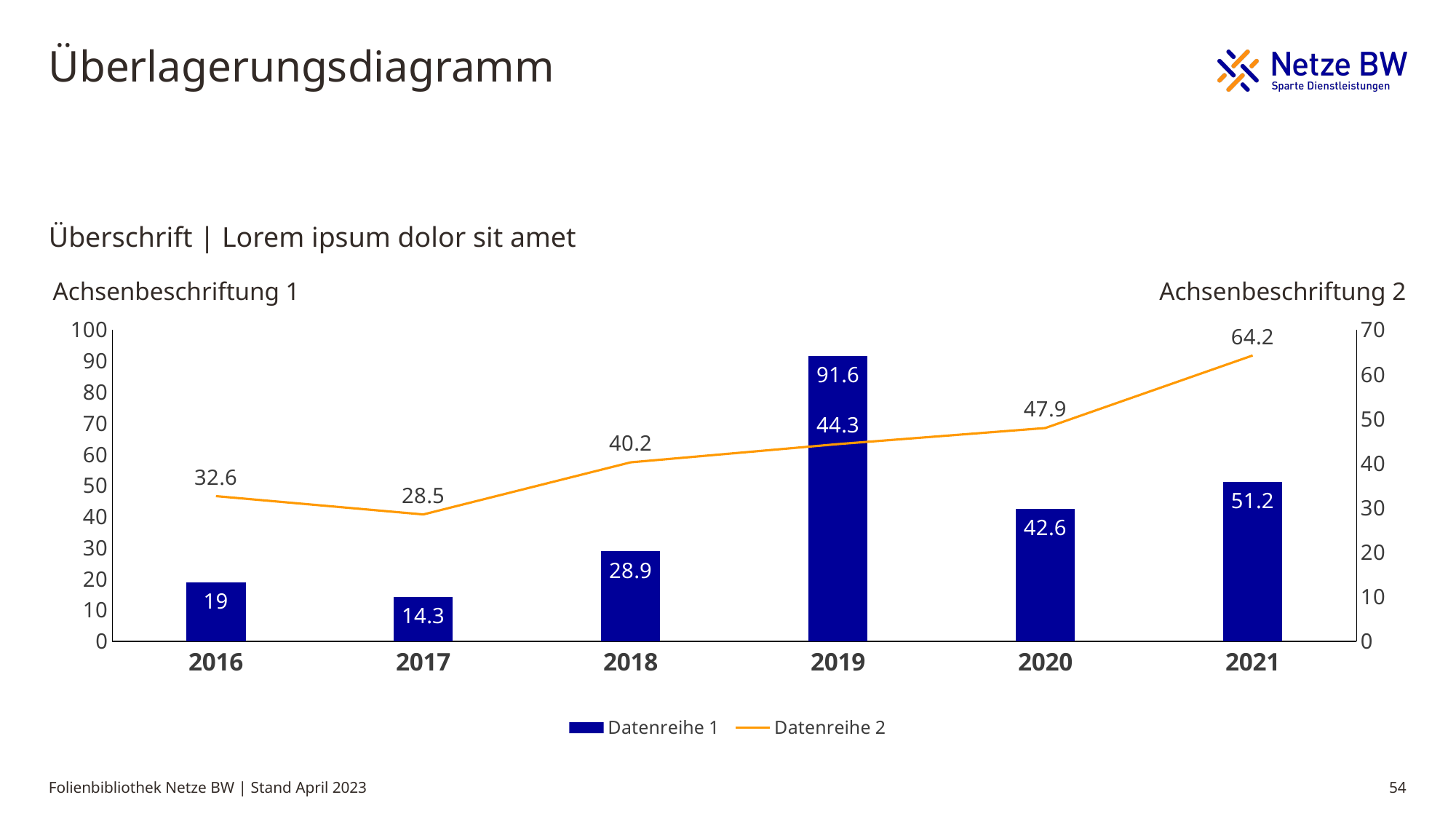
What kind of chart is shown on the slide? Combined bar and line chart What is the value of Datenreihe 2 for 2017? 28.5 Which year has the highest value for Datenreihe 1? 2019 How many years are shown on the x axis? 6 What is the difference between the Datenreihe 1 values for 2021 and 2020? 8.6 Which year has the lowest value for Datenreihe 2? 2017 What is the value of Datenreihe 1 for 2019? 91.6 Which is larger: the Datenreihe 2 value for 2018 or for 2020? 2020 Does Datenreihe 2 rise or fall from 2017 to 2021? Rise What is the value of Datenreihe 1 for 2016? 19 How many series does the legend list? 2 Which year has the lowest value for Datenreihe 1? 2017